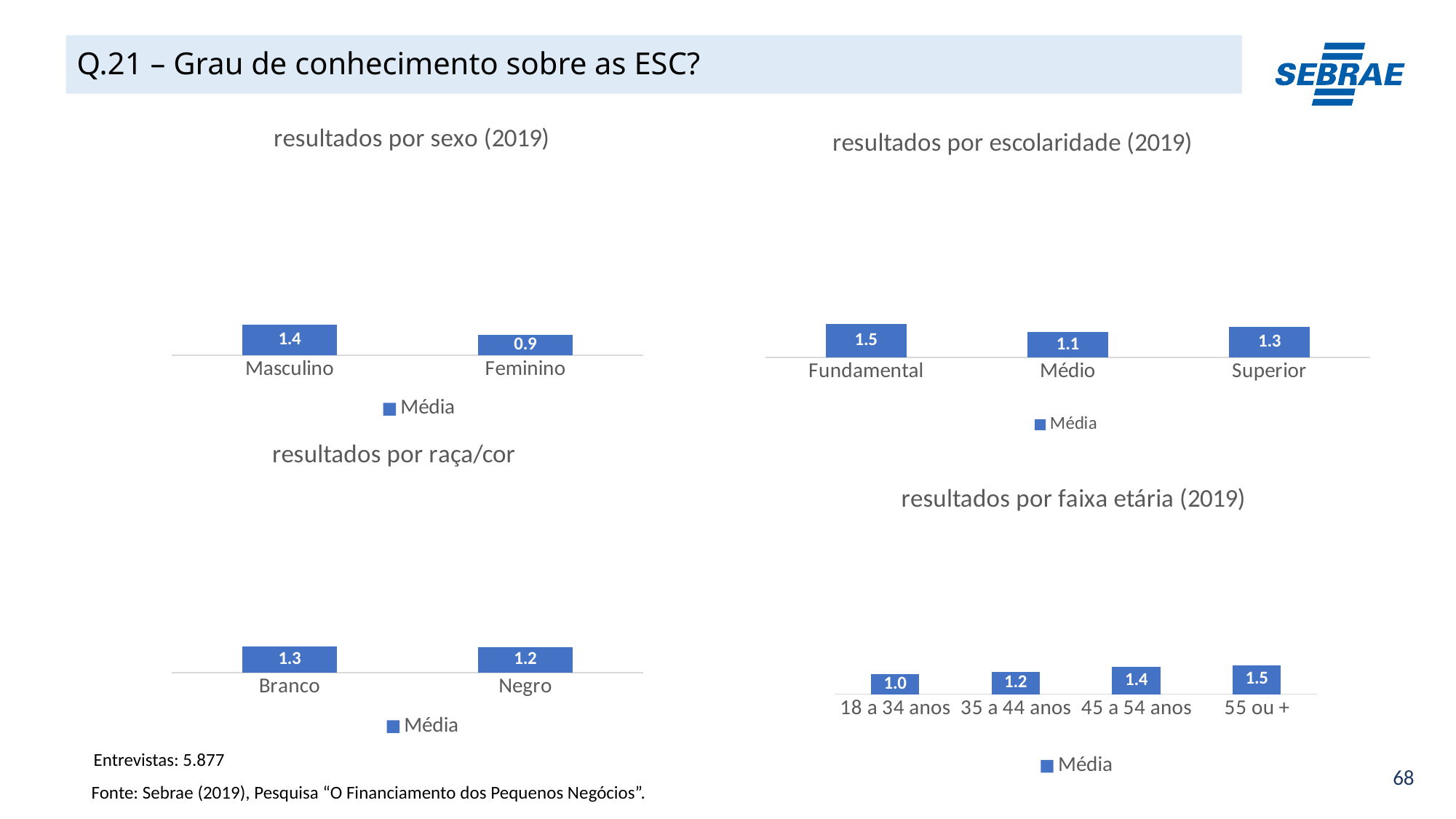
In the chart 'resultados por sexo (2019)', what is the difference between the values for Masculino and Feminino? 0.5 In the chart 'resultados por raça/cor', what is the value for Negro? 1.2 What kind of chart is 'resultados por sexo (2019)'? bar chart In the chart 'resultados por faixa etária (2019)', do the values rise or fall from the youngest to the oldest age group? rise In the chart 'resultados por faixa etária (2019)', what is the difference between the values for 55 ou + and 18 a 34 anos? 0.5 In the chart 'resultados por sexo (2019)', what is the value for Masculino? 1.4 In the chart 'resultados por faixa etária (2019)', what is the value for 35 a 44 anos? 1.2 In the chart 'resultados por escolaridade (2019)', what is the value for Superior? 1.3 In the chart 'resultados por raça/cor', which is larger, the value for Branco or for Negro? Branco In the chart 'resultados por escolaridade (2019)', which category has the highest value? Fundamental In the chart 'resultados por faixa etária (2019)', how many age categories are shown? 4 In the chart 'resultados por escolaridade (2019)', which category has the lowest value? Médio